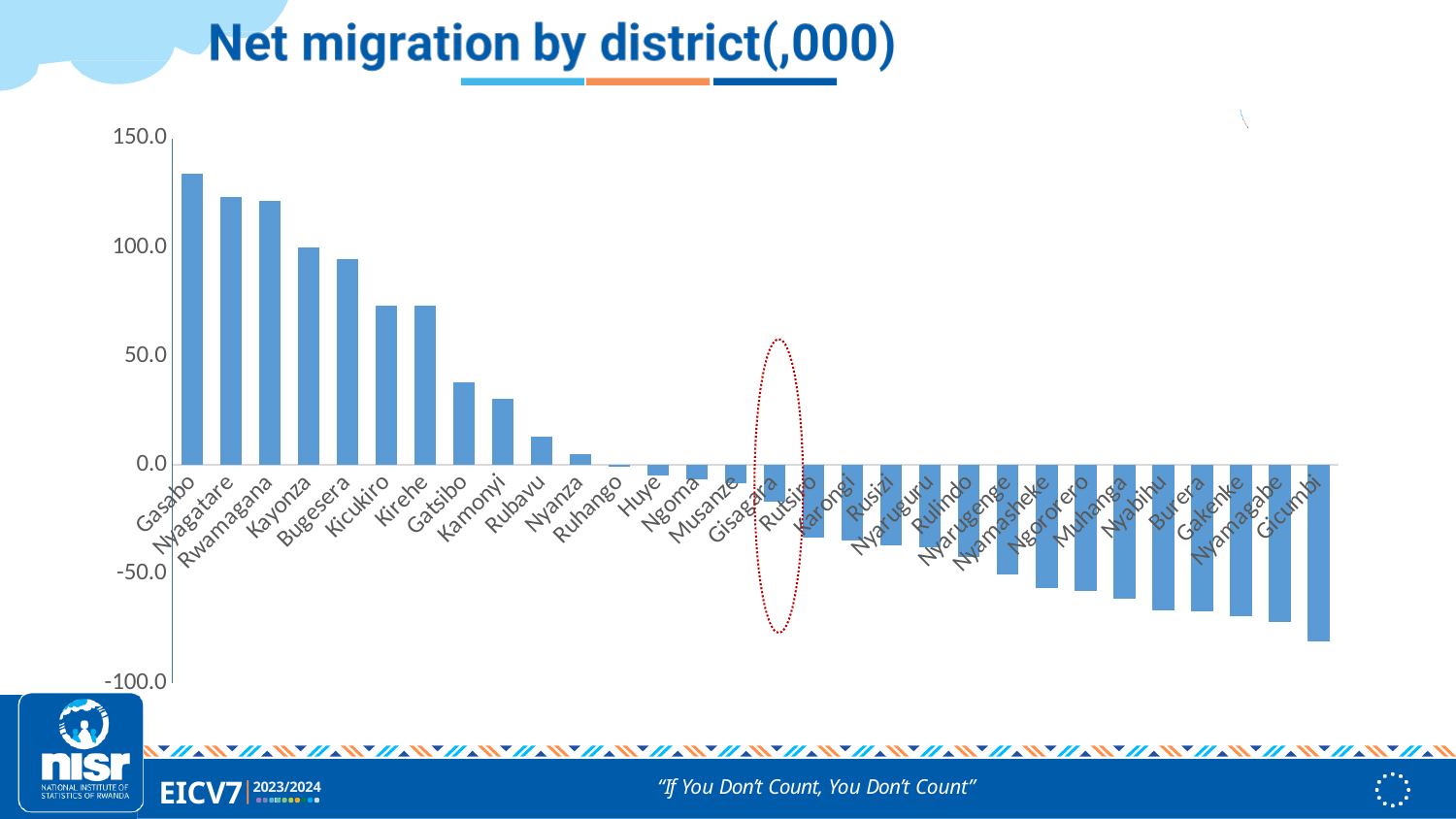
Is the value for Gatsibo greater or less than 50.0? less Is the value for Gicumbi greater or less than -50.0? less What kind of chart is shown on the slide? bar chart Which district has the highest net migration in the chart? Gasabo How many districts are shown on the x axis of the chart? 30 Which district is highlighted with a red dotted circle on the chart? Rutsiro Is the value for Bugesera greater or less than 100.0? less Which district has the larger net migration, Gasabo or Nyagatare? Gasabo What is the title of the chart? Net migration by district(,000) Do the values rise or fall moving from left to right along the x axis? fall Which district has the lowest net migration in the chart? Gicumbi